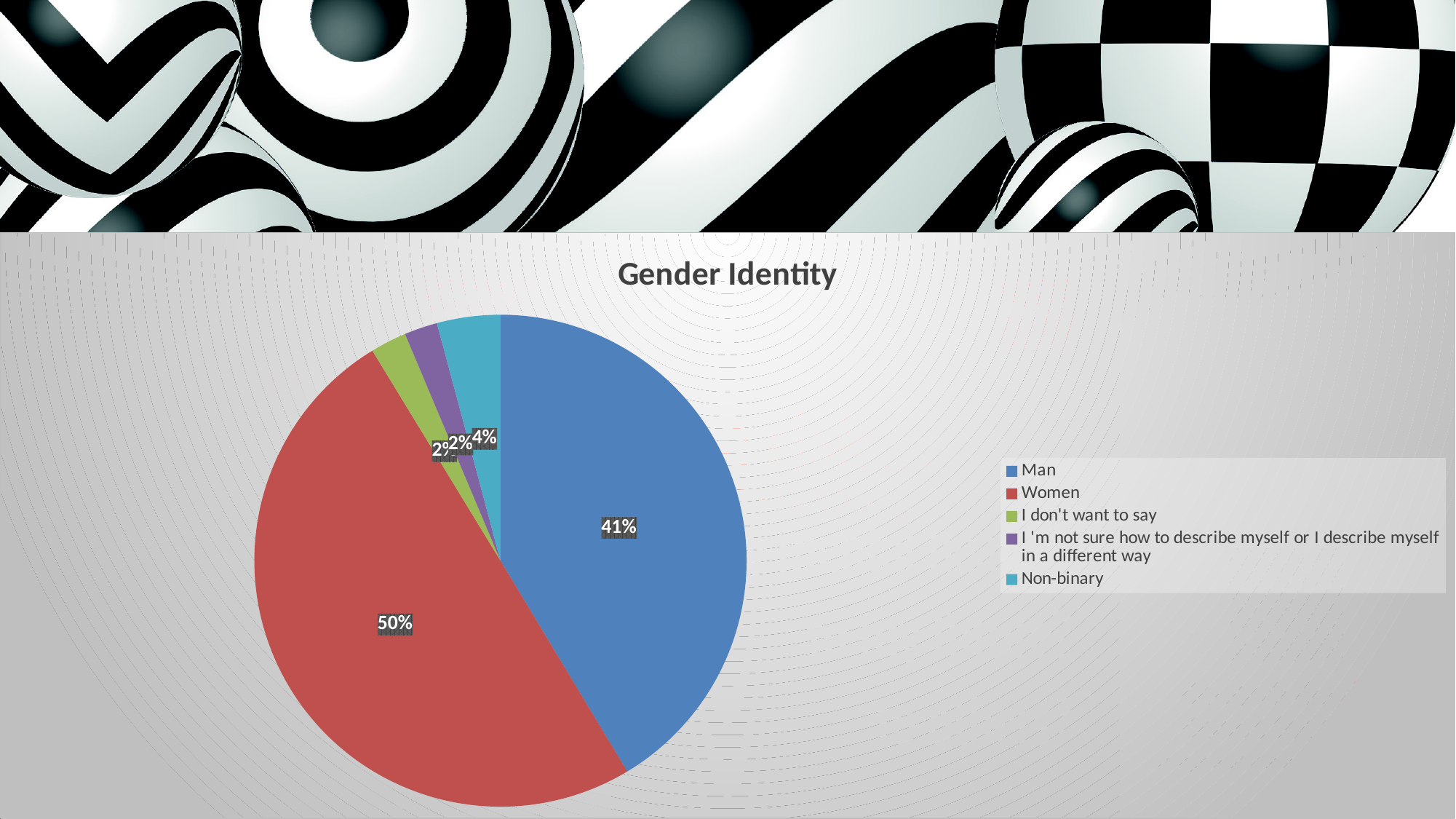
What is the title of the chart? Gender Identity What type of chart is shown on the slide? pie chart Which category has the largest slice of the pie? Women What share of the pie is labelled for Women? 50% Which is larger, the slice for Non-binary or the slice for 'I don't want to say'? Non-binary How many categories does the legend list? 5 What share of the pie is labelled for Non-binary? 4% What colour is the slice for Women? red What share of the pie is labelled for Man? 41% What is the difference in percentage points between the Women slice and the Man slice? 9% Which is larger, the slice for Man or the slice for Women? Women